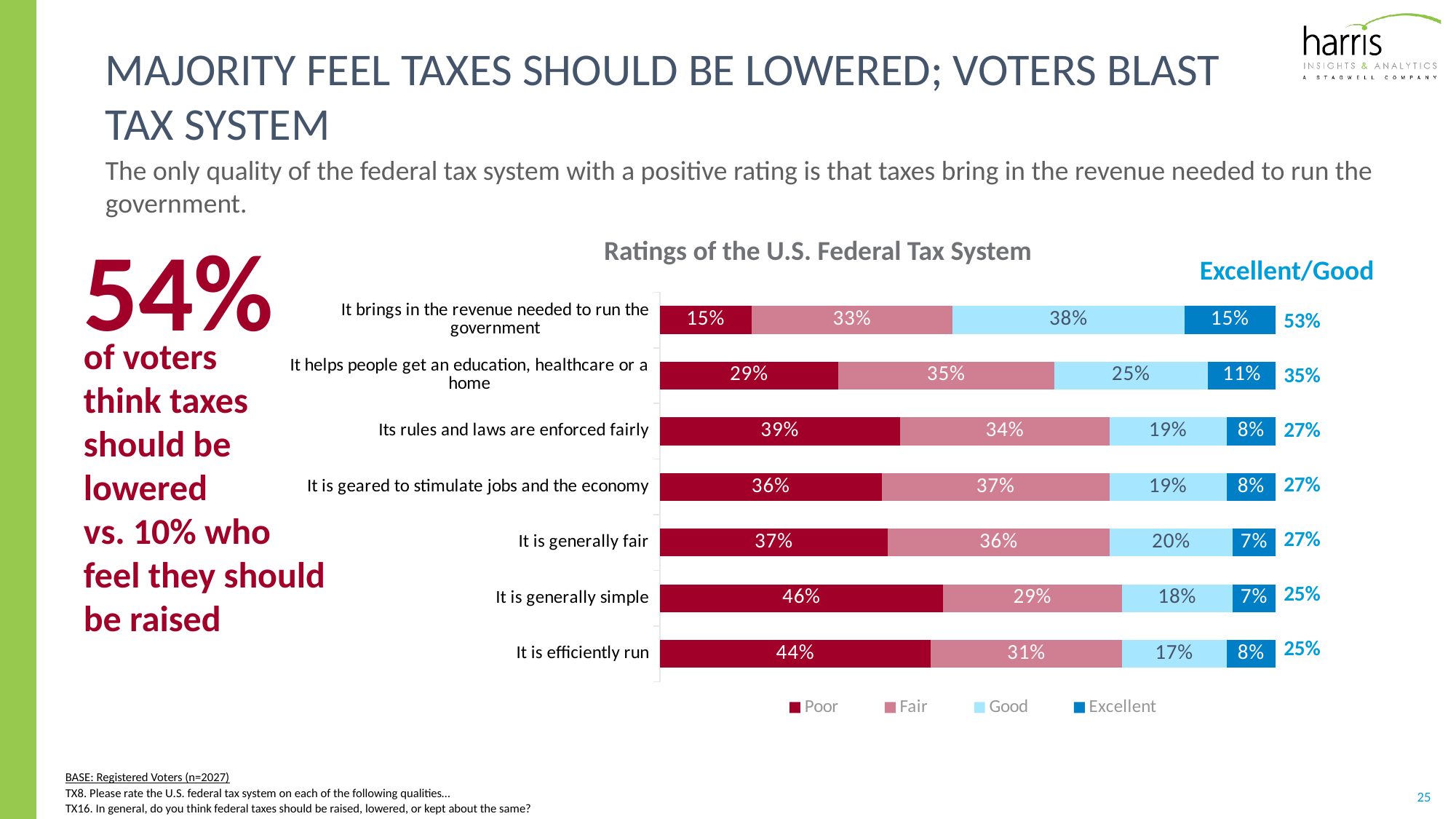
Which quality has the highest Poor rating? It is generally simple What percentage rated 'It brings in the revenue needed to run the government' as Good? 38% How many series does the legend list in the 'Ratings of the U.S. Federal Tax System' chart? 4 What kind of chart is shown on the slide? Stacked bar chart Which has a larger Fair rating: 'It is geared to stimulate jobs and the economy' or 'It is generally simple'? It is geared to stimulate jobs and the economy How many qualities of the tax system are rated in the chart? 7 What is the difference between the Poor rating for 'It is efficiently run' and the Poor rating for 'It is generally fair'? 7 percentage points What is the Excellent rating for 'It helps people get an education, healthcare or a home'? 11% Which quality has the lowest Poor rating? It brings in the revenue needed to run the government What is the title of the chart? Ratings of the U.S. Federal Tax System What is the combined Excellent/Good percentage shown for 'It is efficiently run'? 25% What percentage rated 'It is generally simple' as Poor? 46%